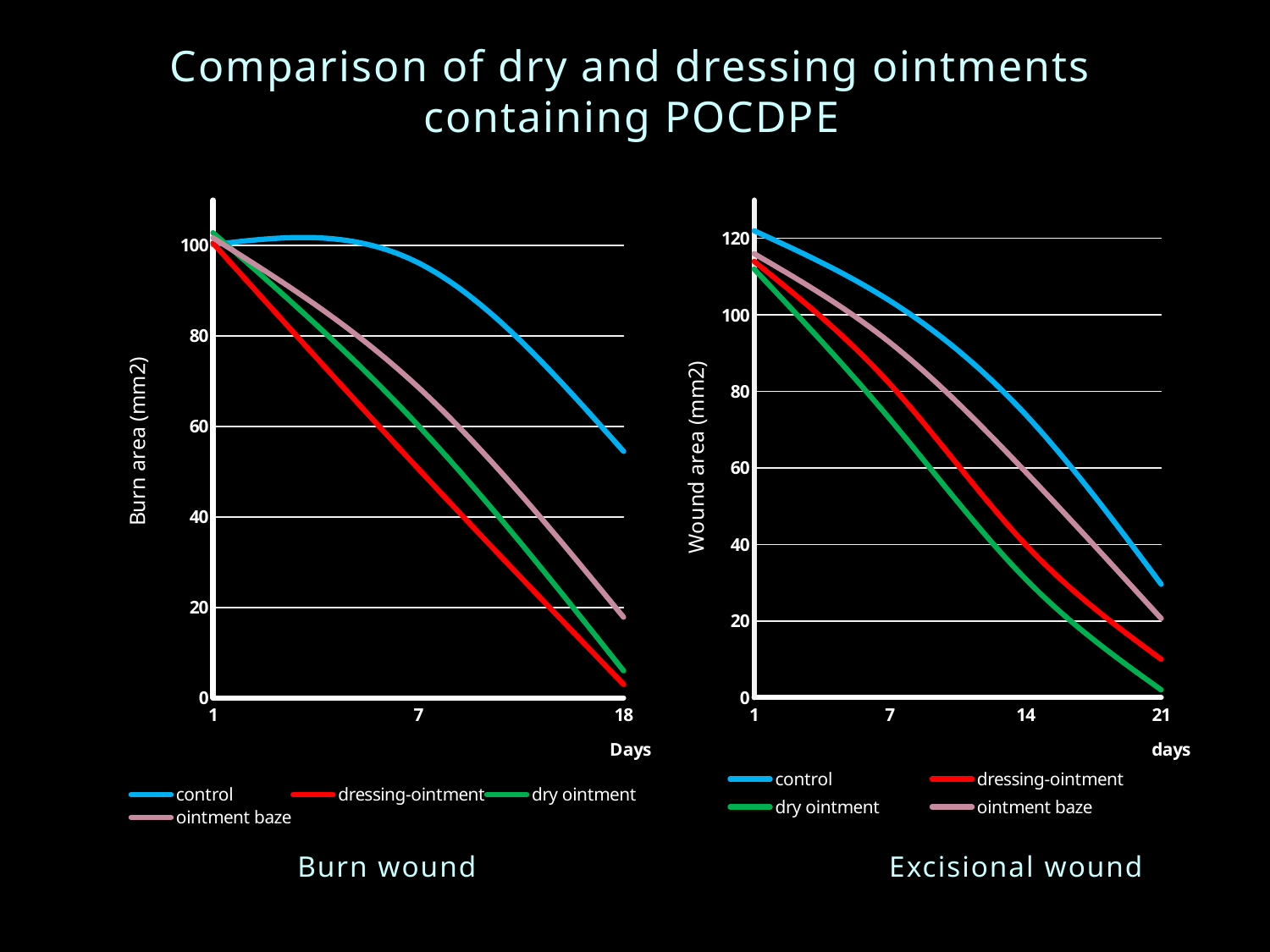
What kind of chart is the Burn wound chart? line chart In the Burn wound chart, is the value for dressing-ointment at day 18 greater or less than 20? less What is the y-axis title of the Excisional wound chart? Wound area (mm2) In the Excisional wound chart, does the dressing-ointment series rise or fall from day 1 to day 21? fall How many series does the legend of the Excisional wound chart list? 4 In the Burn wound chart, which series has the highest value at day 18? control In the Burn wound chart, is the value for control at day 7 greater or less than 80? greater In the Excisional wound chart, which series has the lowest value at day 21? dry ointment In the Excisional wound chart, is the value for control at day 14 greater or less than 60? greater